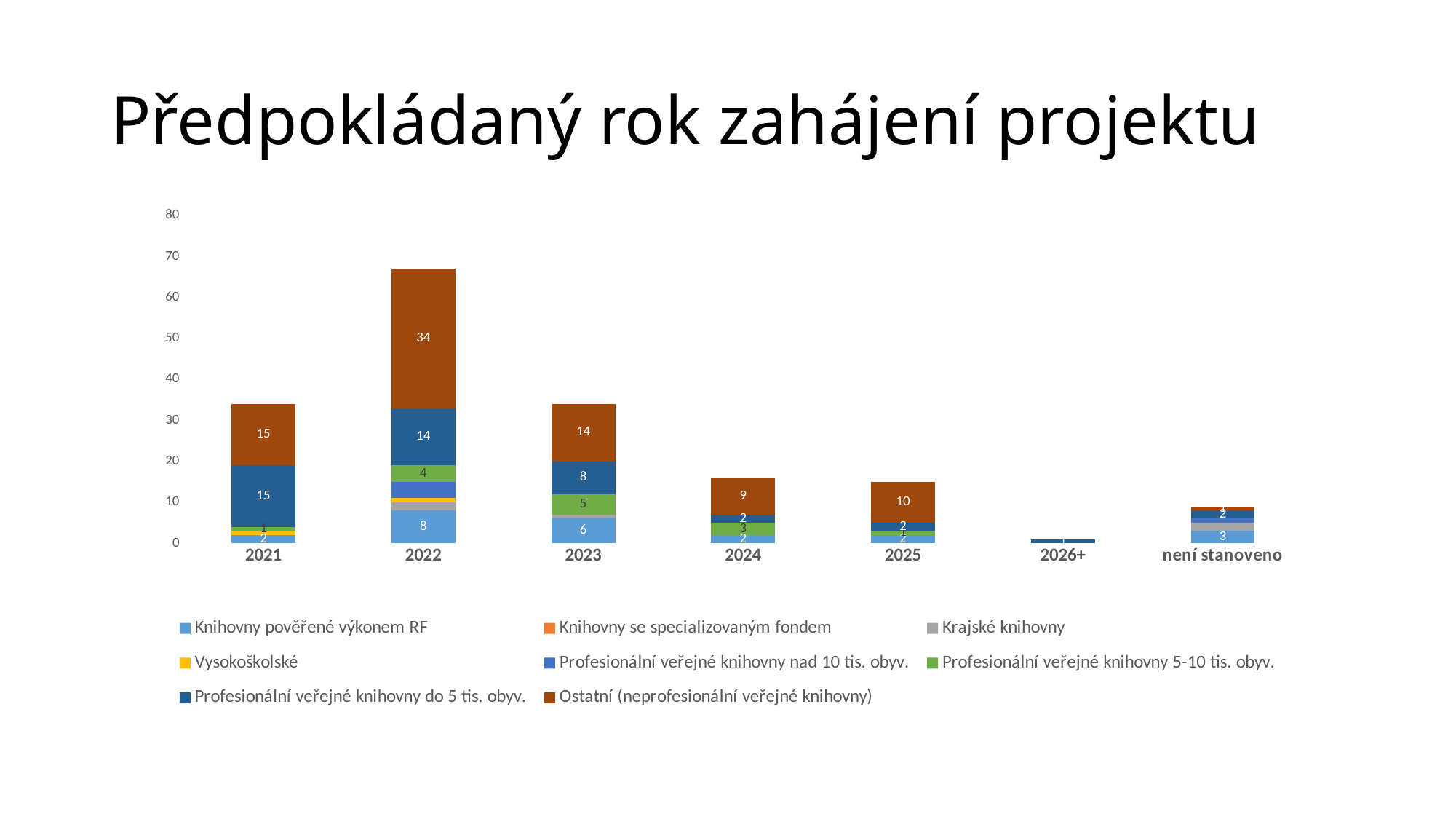
What is the value for Ostatní (neprofesionální veřejné knihovny) in 2022? 34 Is the total of the stacked bar for 2022 greater or less than 60? greater What kind of chart is shown on the slide? stacked bar chart How many series does the legend list? 8 What is the title of the chart? Předpokládaný rok zahájení projektu Which category has the tallest stacked bar? 2022 How many categories are shown on the x axis? 7 What is the value for Ostatní (neprofesionální veřejné knihovny) in 2025? 10 What is the difference between the Ostatní (neprofesionální veřejné knihovny) values for 2022 and 2023? 20 What is the value for Knihovny pověřené výkonem RF in 2023? 6 What is the value for Profesionální veřejné knihovny do 5 tis. obyv. in 2021? 15 Which category has the smallest stacked bar? 2026+